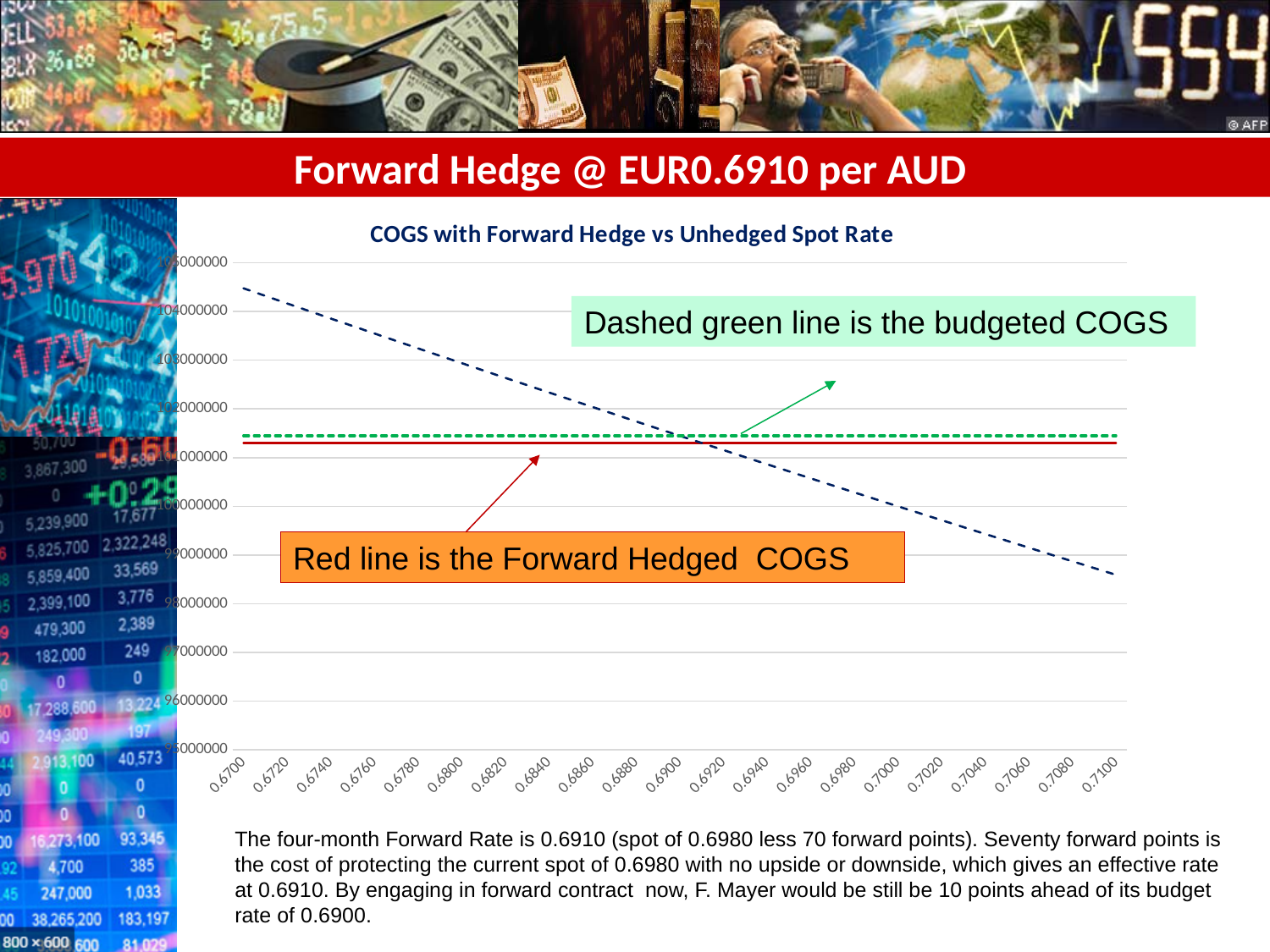
Is the value of the red Forward Hedged COGS line greater or less than 100000000? greater Is the value of the dashed blue unhedged line at 0.7100 greater or less than 99000000? less Is the value of the red Forward Hedged COGS line greater or less than 102000000? less At an exchange rate of 0.7100, which is higher: the dashed blue unhedged line or the red Forward Hedged COGS line? the red Forward Hedged COGS line What is the title of the chart? COGS with Forward Hedge vs Unhedged Spot Rate How many exchange-rate tick labels are shown along the x axis? 21 According to the annotation on the chart, what does the dashed green line represent? the budgeted COGS At an exchange rate of 0.6700, which is higher: the dashed blue unhedged line or the red Forward Hedged COGS line? the dashed blue unhedged line What is the lowest value labelled on the y axis? 95000000 What kind of chart is shown on the slide? line chart Does the dashed blue unhedged spot rate line rise or fall as the exchange rate increases along the x axis? fall